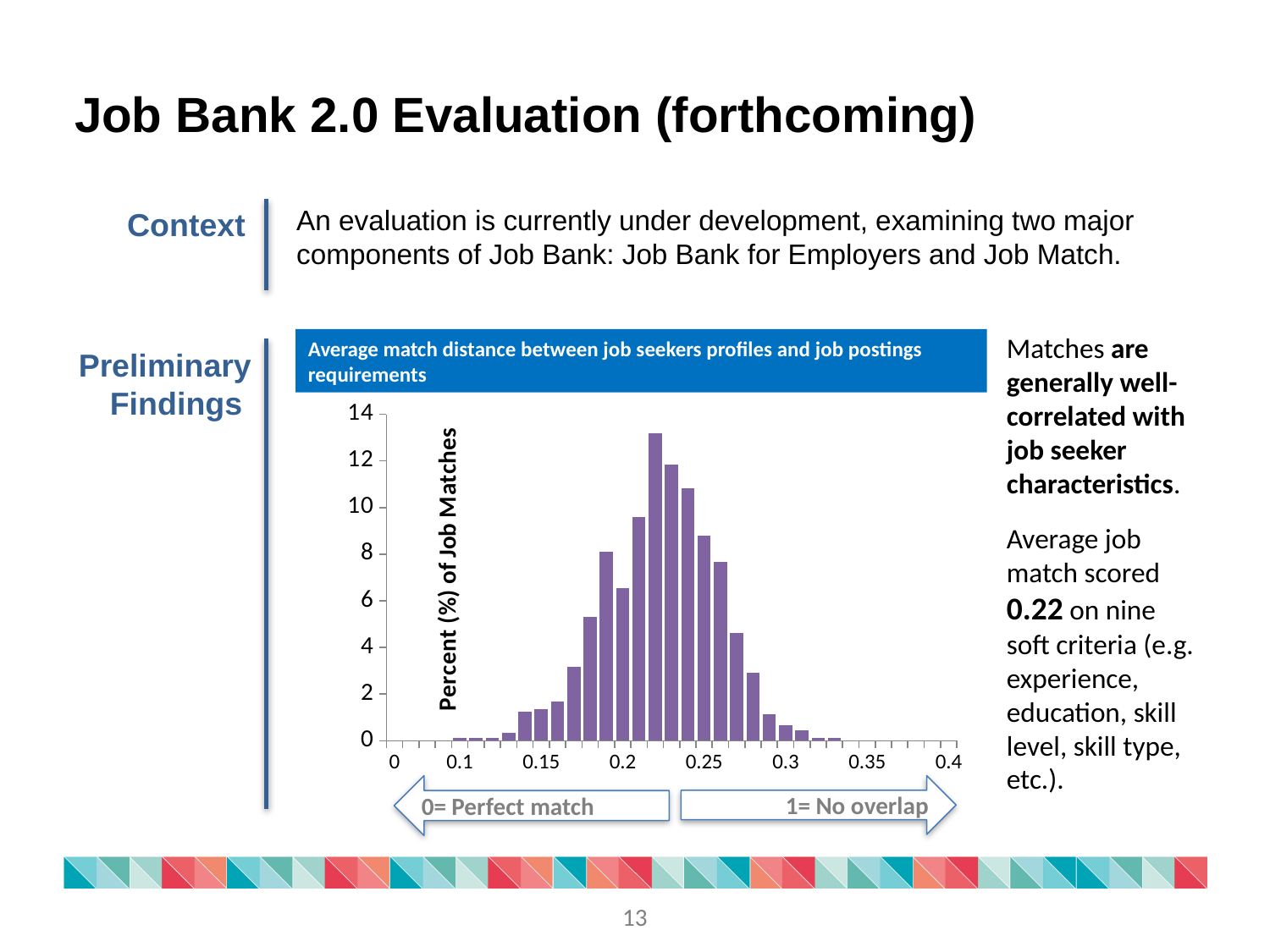
What kind of chart is shown on the slide? bar chart Is the value for the bar at 0.3 greater or less than 2? less Do the bar values rise or fall along the x axis from 0.25 to 0.35? fall What is the title of the chart? Average match distance between job seekers profiles and job postings requirements Which bar is taller, the one at 0.2 or the one at 0.3? 0.2 Is the value for the bar at 0.2 greater or less than 8? less Is the value for the bar at 0.15 greater or less than 2? less Which bar is taller, the one at 0.15 or the one at 0.25? 0.25 Do the bar values rise or fall along the x axis from 0.1 to 0.2? rise What is the label on the vertical axis of the chart? Percent (%) of Job Matches